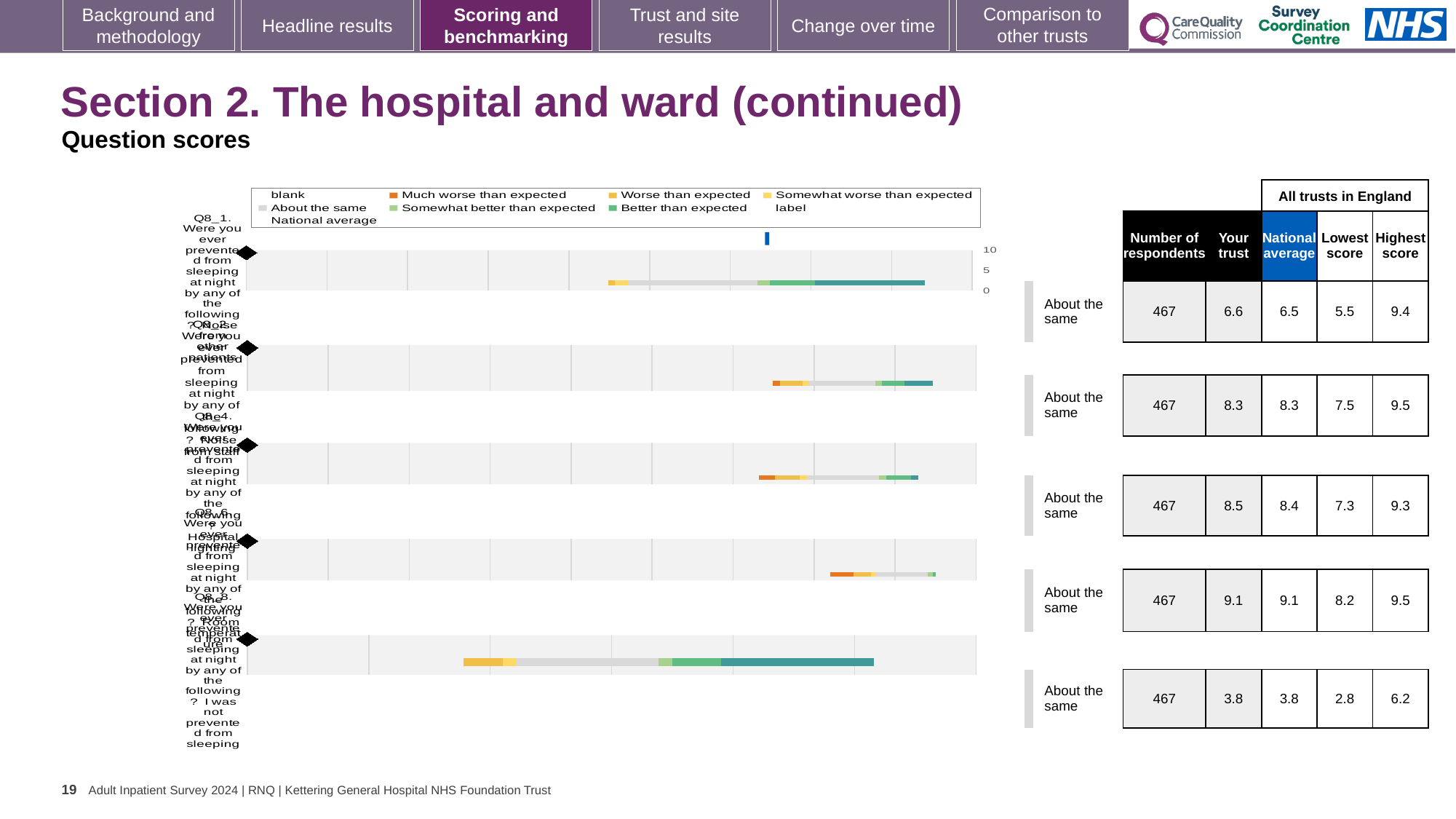
How many respondents are listed for each question row? 467 What is the highest score across all trusts in England for the third row (Q8_4)? 9.3 Which row has the lowest 'Your trust' score? Q8_8 (fifth row), 3.8 What is the lowest score across all trusts in England for the fifth row (Q8_8)? 2.8 What is the national average for the second row (Q8_2)? 8.3 What kind of chart is shown on the slide? bar chart How many question rows (bars) are plotted in the chart? 5 What benchmark category is shown for every row in the chart? About the same For the third row (Q8_4), what is the difference between the 'Your trust' score and the national average? 0.1 Which row has the highest 'Your trust' score? Q8_6 (fourth row), 9.1 For the first row (Q8_1), which is larger: the 'Your trust' score or the national average? Your trust What is the 'Your trust' score for the first row (Q8_1)? 6.6